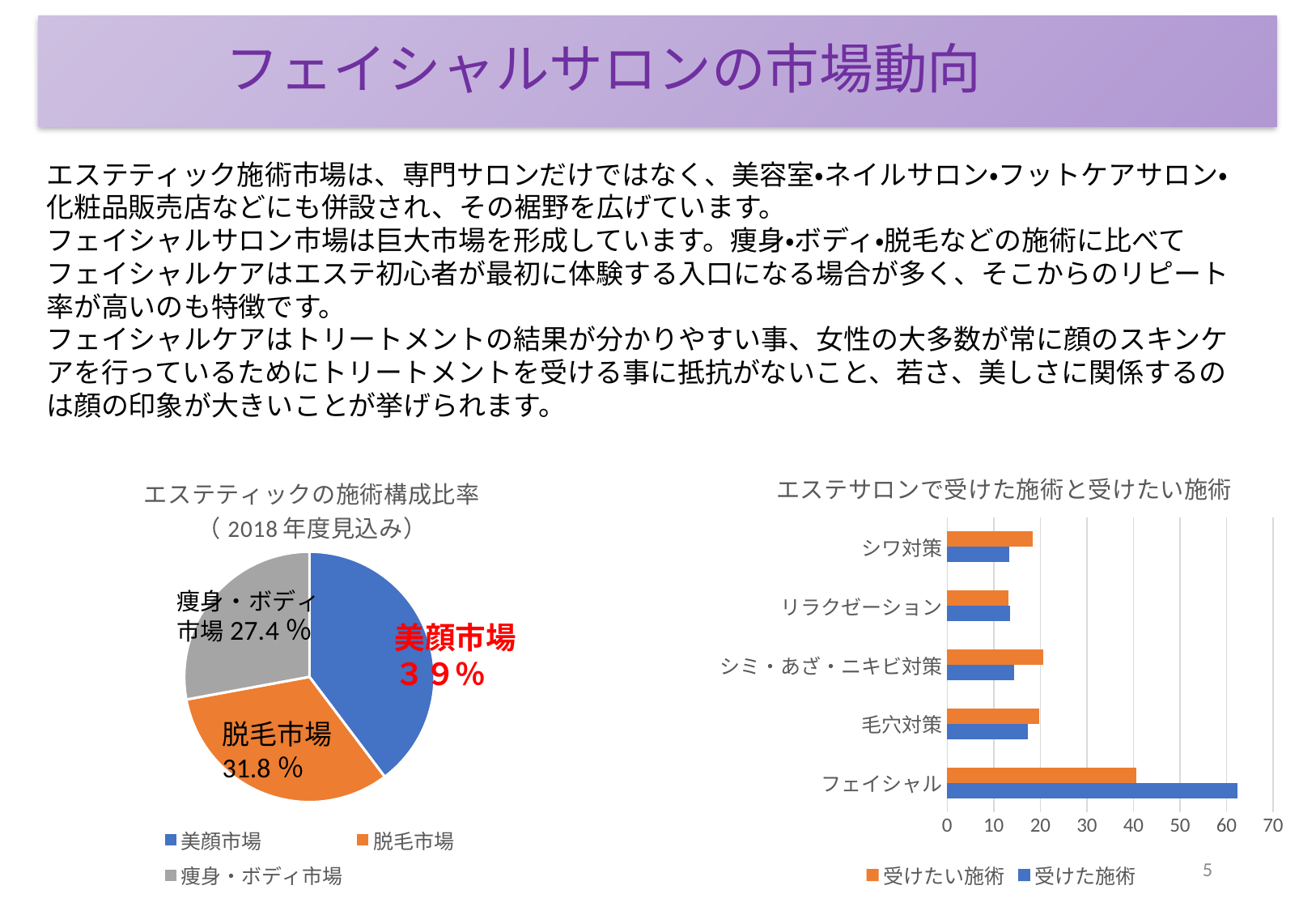
In the pie chart エステティックの施術構成比率, which market has the smallest share? 痩身・ボディ市場 In the chart エステサロンで受けた施術と受けたい施術, which category has the highest value for 受けた施術? フェイシャル How many series does the legend of the chart エステサロンで受けた施術と受けたい施術 list? 2 In the chart エステサロンで受けた施術と受けたい施術, for シワ対策, which is larger: 受けたい施術 or 受けた施術? 受けたい施術 What kind of chart is エステサロンで受けた施術と受けたい施術? bar chart How many slices does the pie chart エステティックの施術構成比率 have? 3 In the chart エステサロンで受けた施術と受けたい施術, is the value of 受けた施術 for フェイシャル greater or less than 50? greater In the pie chart エステティックの施術構成比率, what share does 脱毛市場 have? 31.8% In the pie chart エステティックの施術構成比率, what share does 痩身・ボディ市場 have? 27.4% In the pie chart エステティックの施術構成比率, what share does 美顔市場 have? 39% In the pie chart エステティックの施術構成比率, how many percentage points larger is 美顔市場 than 脱毛市場? 7.2% In the pie chart エステティックの施術構成比率, which market has the largest share? 美顔市場